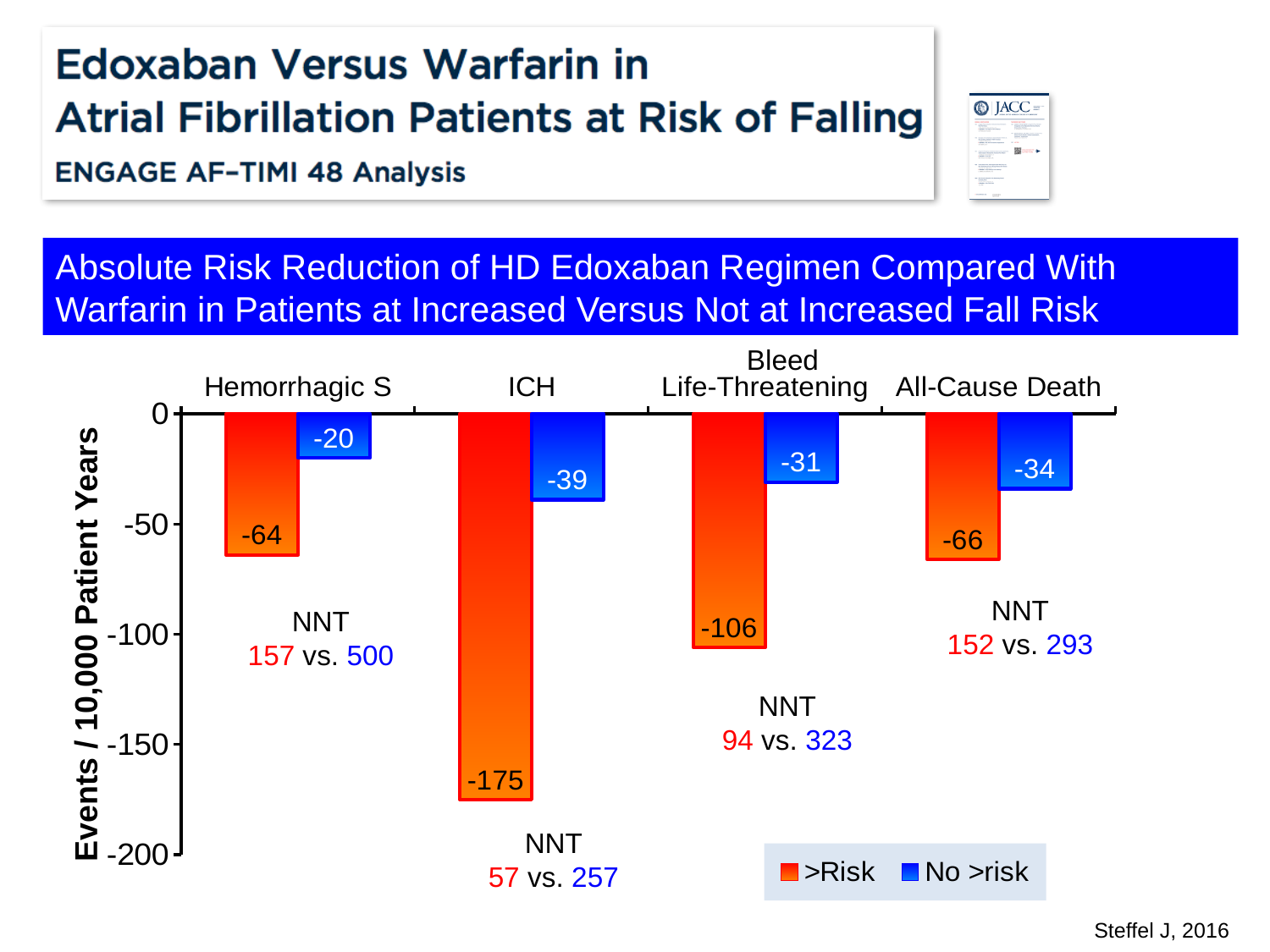
How many categories are shown on the x axis? 4 What is the difference between the >Risk and No >risk values in the ICH category? 136 What is the value for the >Risk series in the ICH category? -175 What is the value for the No >risk series in the All-Cause Death category? -34 What is the value for the No >risk series in the Hemorrhagic S category? -20 Which category has the highest (least negative) value for the No >risk series? Hemorrhagic S What is the difference between the >Risk and No >risk values in the All-Cause Death category? 32 Which category has the lowest (most negative) value for the >Risk series? ICH How many series does the legend list? 2 Which is more negative: the >Risk value for Hemorrhagic S or the >Risk value for All-Cause Death? All-Cause Death What is the value for the >Risk series in the Bleed Life-Threatening category? -106 What kind of chart is shown on the slide? Bar chart